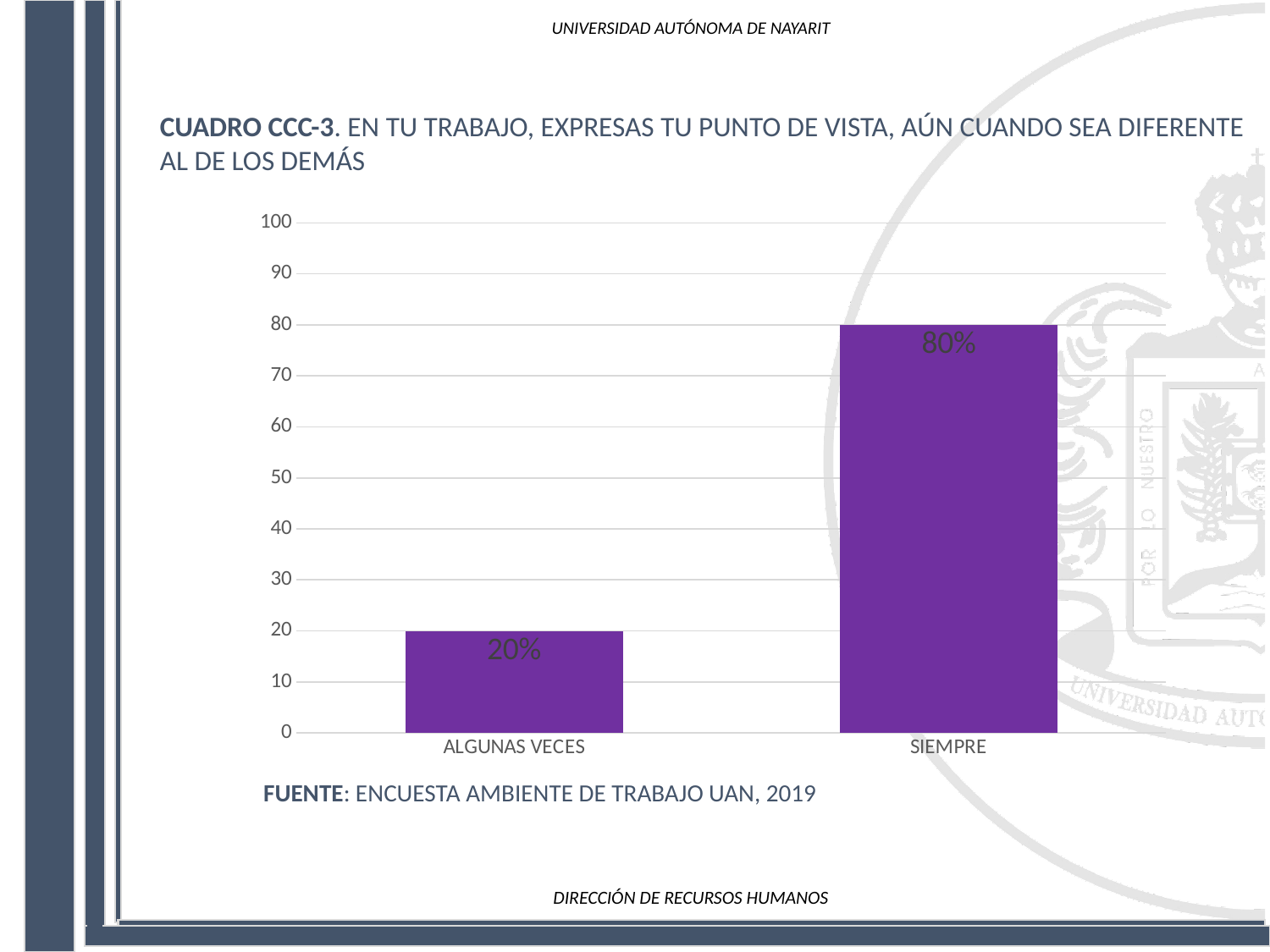
What is the value for SIEMPRE? 80% Is the value for ALGUNAS VECES greater or less than 30? less How many categories are shown in the chart? 2 What is the value for ALGUNAS VECES? 20% What is the total of the two values shown in the chart? 100% Which category has the highest value? SIEMPRE What kind of chart is shown on the slide? bar chart Which category has the lowest value? ALGUNAS VECES What is the difference between the values for SIEMPRE and ALGUNAS VECES? 60% Which is larger, the value for ALGUNAS VECES or the value for SIEMPRE? SIEMPRE Is the value for SIEMPRE greater or less than 50? greater What is the source cited below the chart? ENCUESTA AMBIENTE DE TRABAJO UAN, 2019